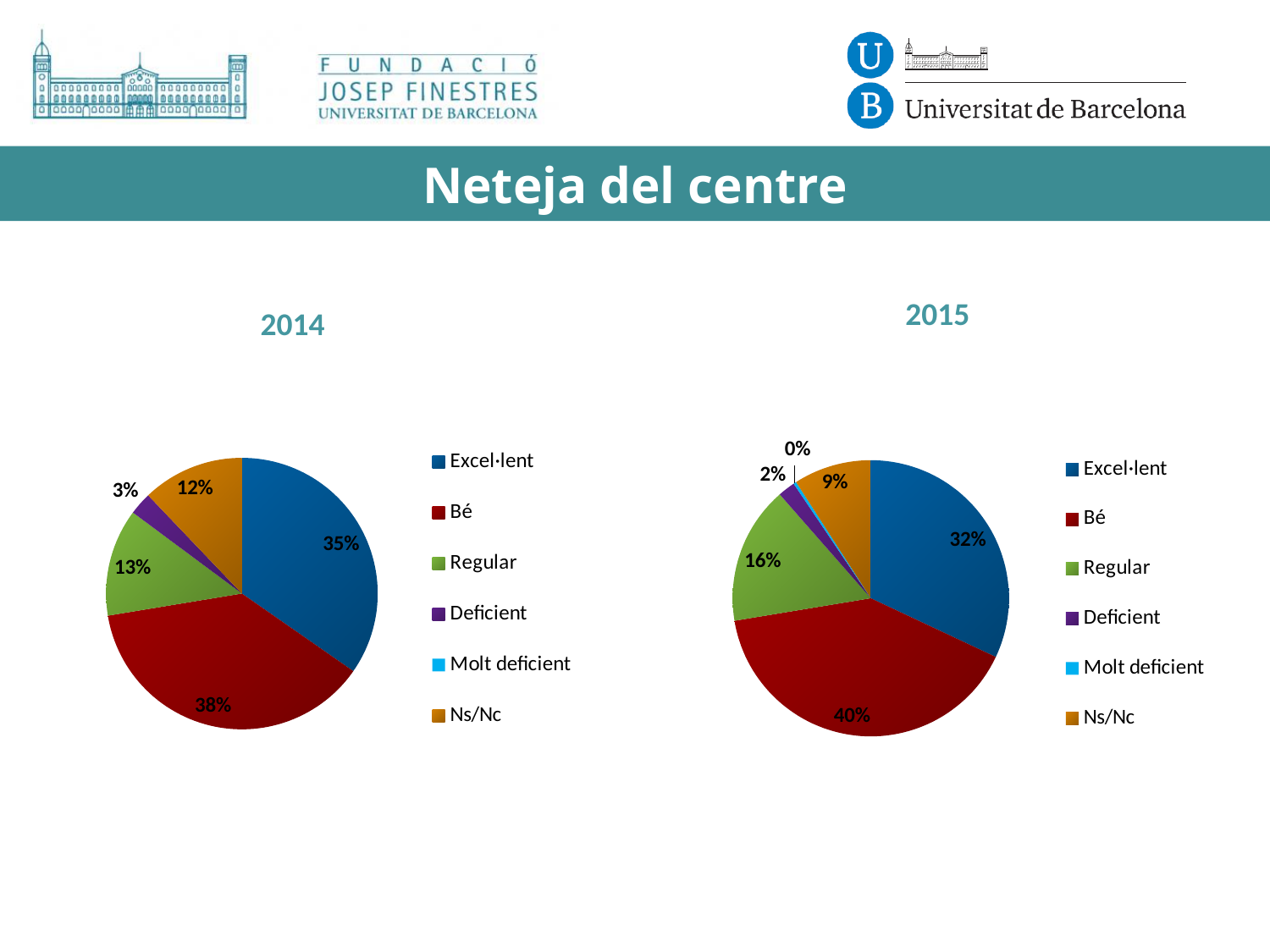
In the 2015 pie chart, what percentage is shown for Excel·lent? 32% In the 2014 pie chart, what percentage is shown for Bé? 38% In the 2014 pie chart, what percentage is shown for Ns/Nc? 12% In the 2015 pie chart, what percentage is shown for Regular? 16% In the 2015 pie chart, what is the difference between the Bé and Excel·lent percentages? 8% What is the title shown above the two charts on the slide? Neteja del centre What type of chart is used for the 2014 data? Pie chart In the 2015 pie chart, which category has the smallest share? Molt deficient Which is larger in the 2014 pie chart, Regular or Ns/Nc? Regular How many entries does the legend of the 2015 chart list? 6 In the 2015 pie chart, what percentage is shown for Molt deficient? 0% In the 2014 pie chart, which category has the largest share? Bé